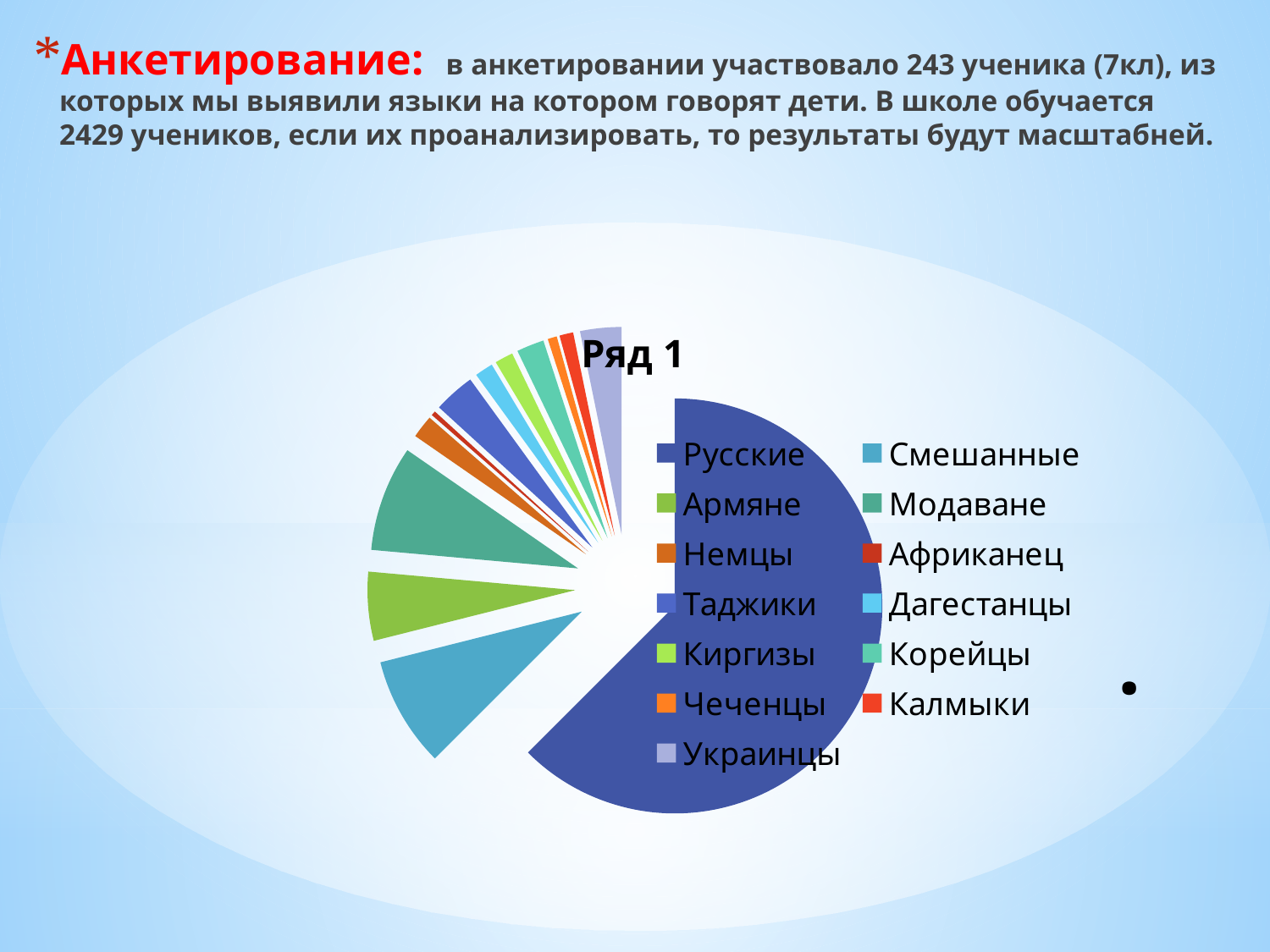
Which slice is larger, Модаване or Немцы? Модаване Which slice is larger, Смешанные or Армяне? Смешанные Does the Русские slice take up more or less than half of the pie? more Which category has the largest slice of the pie chart? Русские Which slice is larger, Модаване or Украинцы? Модаване What is the title of the pie chart? Ряд 1 How many data series does the pie chart plot? 1 What kind of chart is shown on the slide? pie chart How many categories does the pie chart's legend list? 13